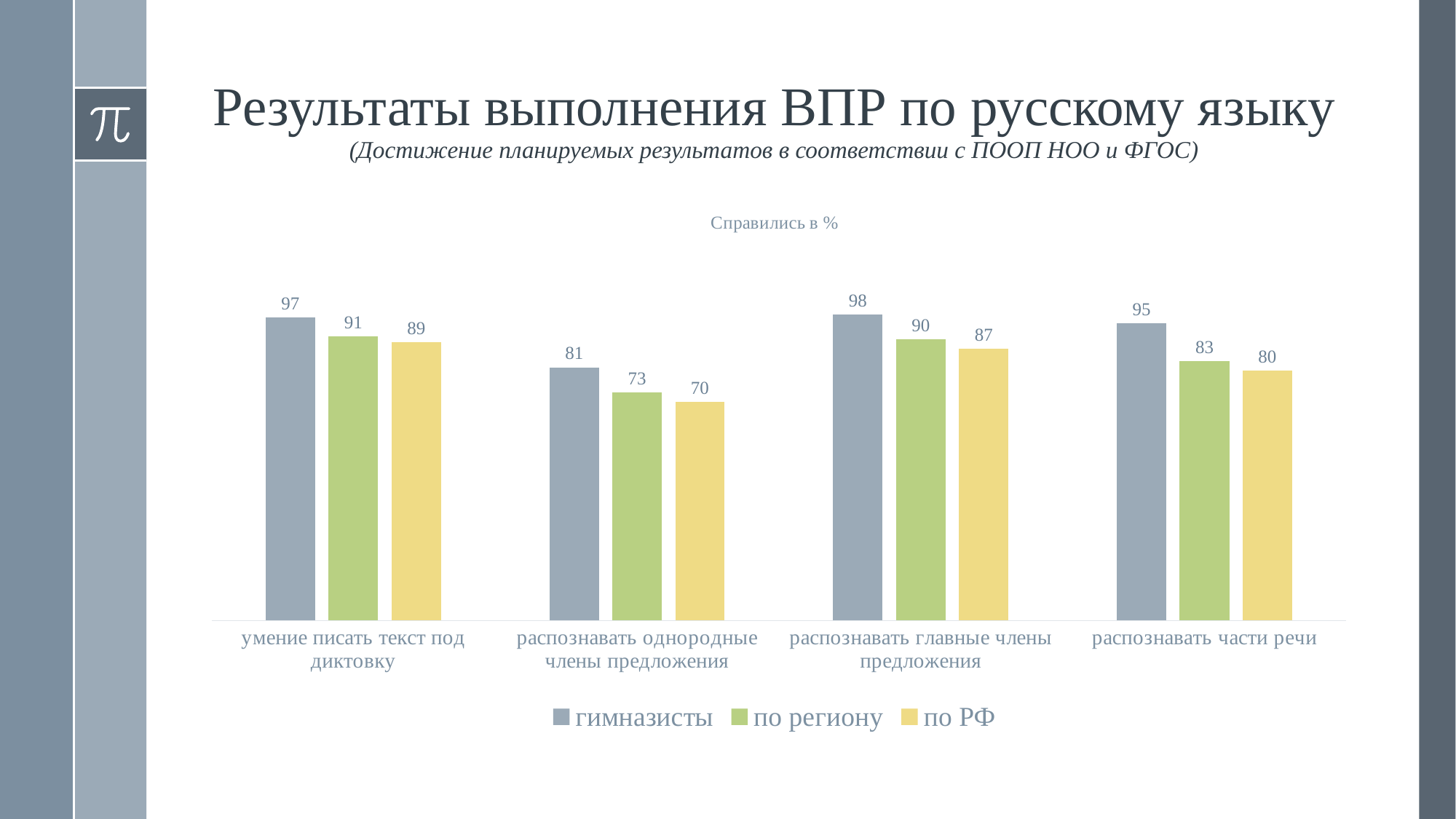
What is the value for гимназисты in the category 'умение писать текст под диктовку'? 97 Which is larger in the category 'распознавать части речи': the value for по региону or the value for по РФ? по региону What is the value for по региону in the category 'распознавать части речи'? 83 In which category is the value for гимназисты the highest? распознавать главные члены предложения What kind of chart is shown on the slide? bar chart What is the title of the chart? Справились в % Which series is shown in yellow? по РФ What is the value for по РФ in the category 'распознавать однородные члены предложения'? 70 What is the difference between the гимназисты and по РФ values in the category 'распознавать однородные члены предложения'? 11 How many categories are shown on the x axis? 4 In which category is the value for по региону the lowest? распознавать однородные члены предложения How many series does the legend list? 3